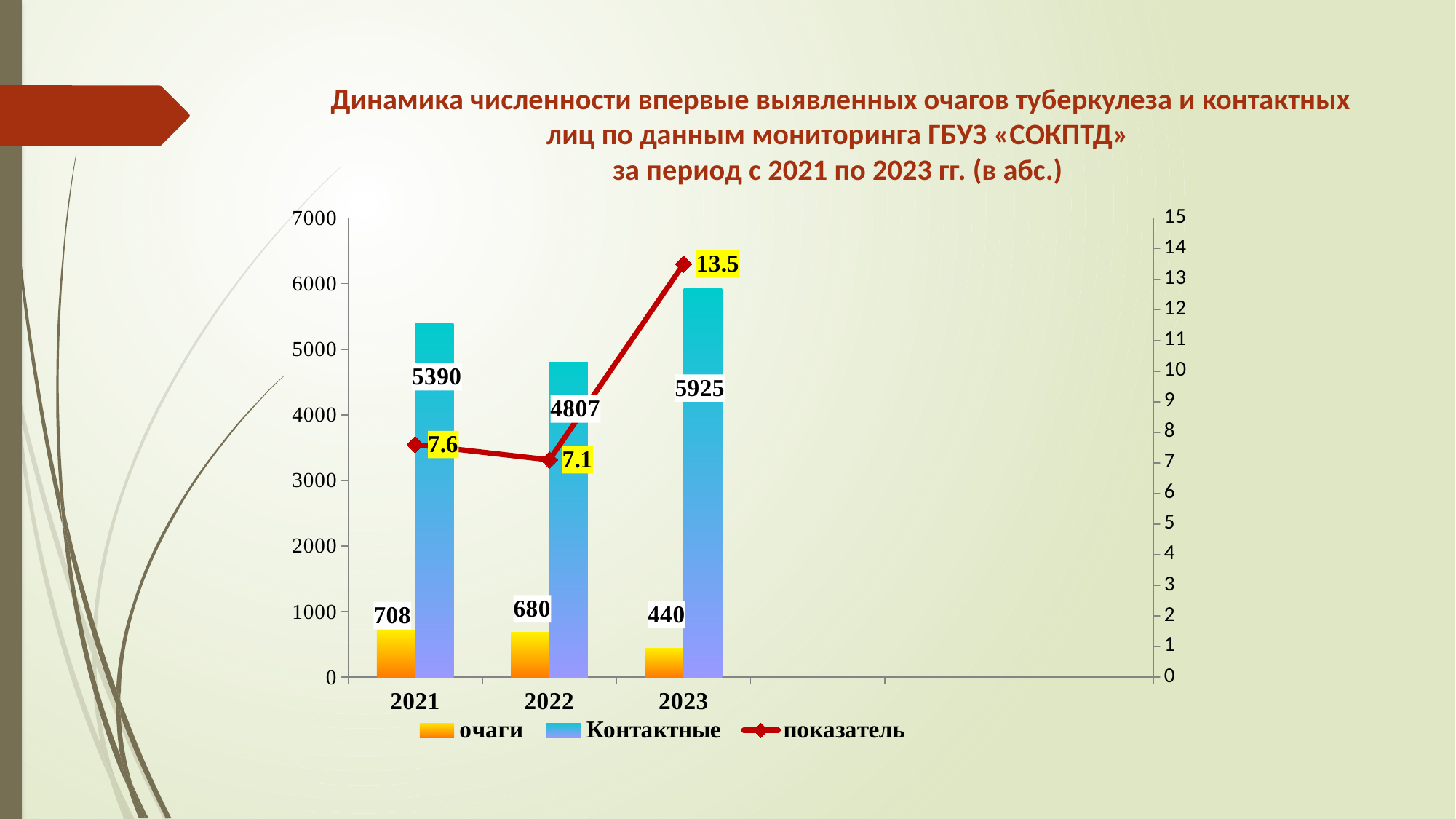
Does the показатель line rise or fall from 2022 to 2023? rises What is the difference between the Контактные values for 2023 and 2022? 1118 In which year is the очаги value lowest? 2023 What is the value of показатель for 2023? 13.5 Which is larger, the показатель value for 2021 or for 2022? 2021 How many years are shown on the x axis? 3 How many series does the legend list? 3 What is the difference between the очаги values for 2021 and 2023? 268 What is the value of очаги for 2021? 708 In which year is the Контактные value highest? 2023 Which series is drawn as a line with diamond markers? показатель What is the value of Контактные for 2022? 4807